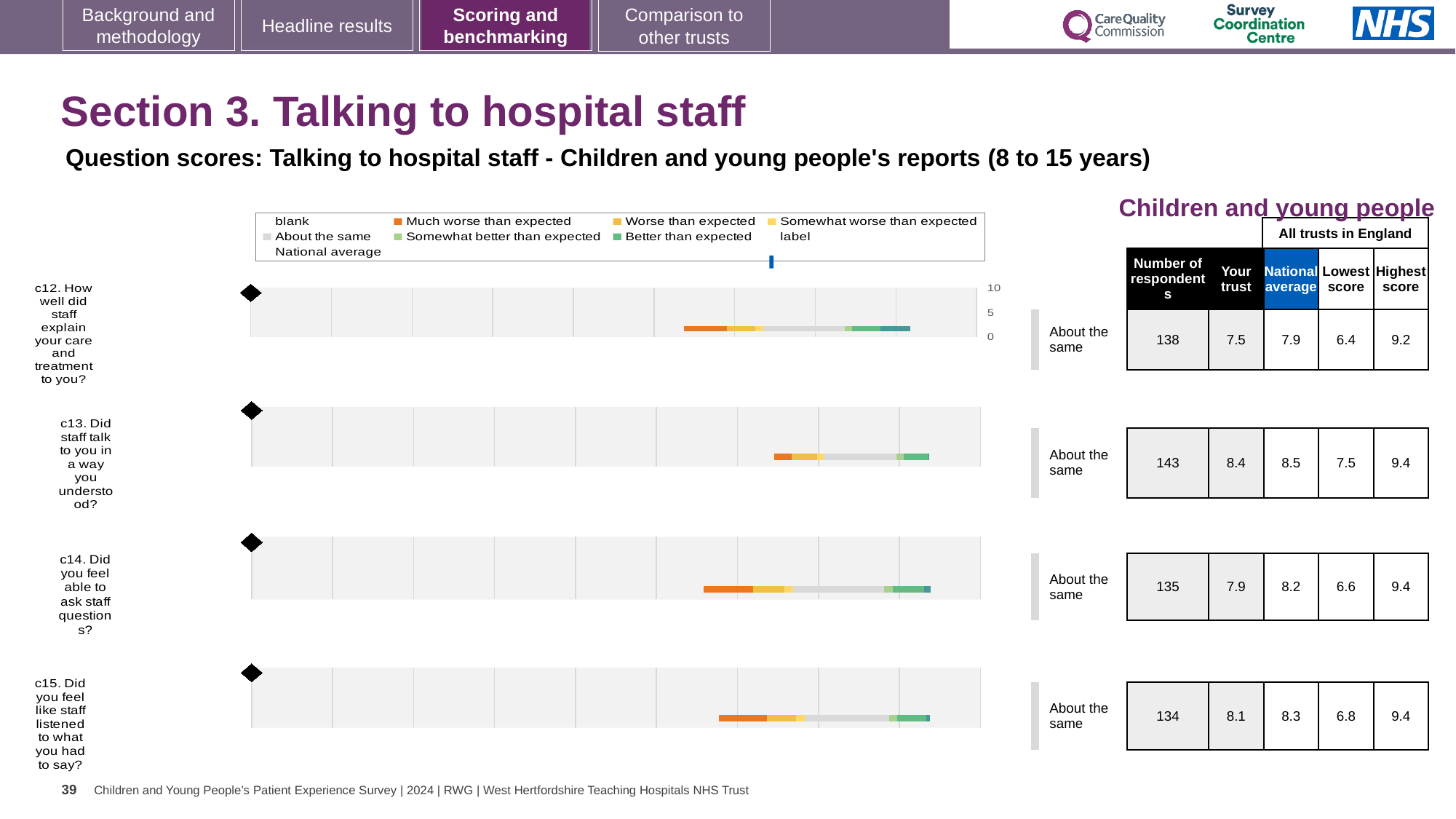
Which of the four questions (c12 to c15) has the lowest 'Your trust' score? c12 In the chart legend, what does the orange colour represent? Much worse than expected For the c15 chart (Did you feel like staff listened to what you had to say?), what is the highest score among all trusts in England? 9.4 For the c14 chart (Did you feel able to ask staff questions?), how many respondents are listed? 135 For the c12 chart (How well did staff explain your care and treatment to you?), what is the 'Your trust' score shown in the table? 7.5 What kind of chart is used to show the question scores for c12 to c15? bar chart For the c12 chart, what is the difference between the national average (7.9) and the 'Your trust' score (7.5)? 0.4 How many survey questions (c12 to c15) have a benchmark chart on the slide? 4 For the c13 chart (Did staff talk to you in a way you understood?), what is the national average score? 8.5 Which of the four questions (c12 to c15) has the highest 'Your trust' score? c13 For the c14 chart, which is larger: the 'Your trust' score or the national average? National average